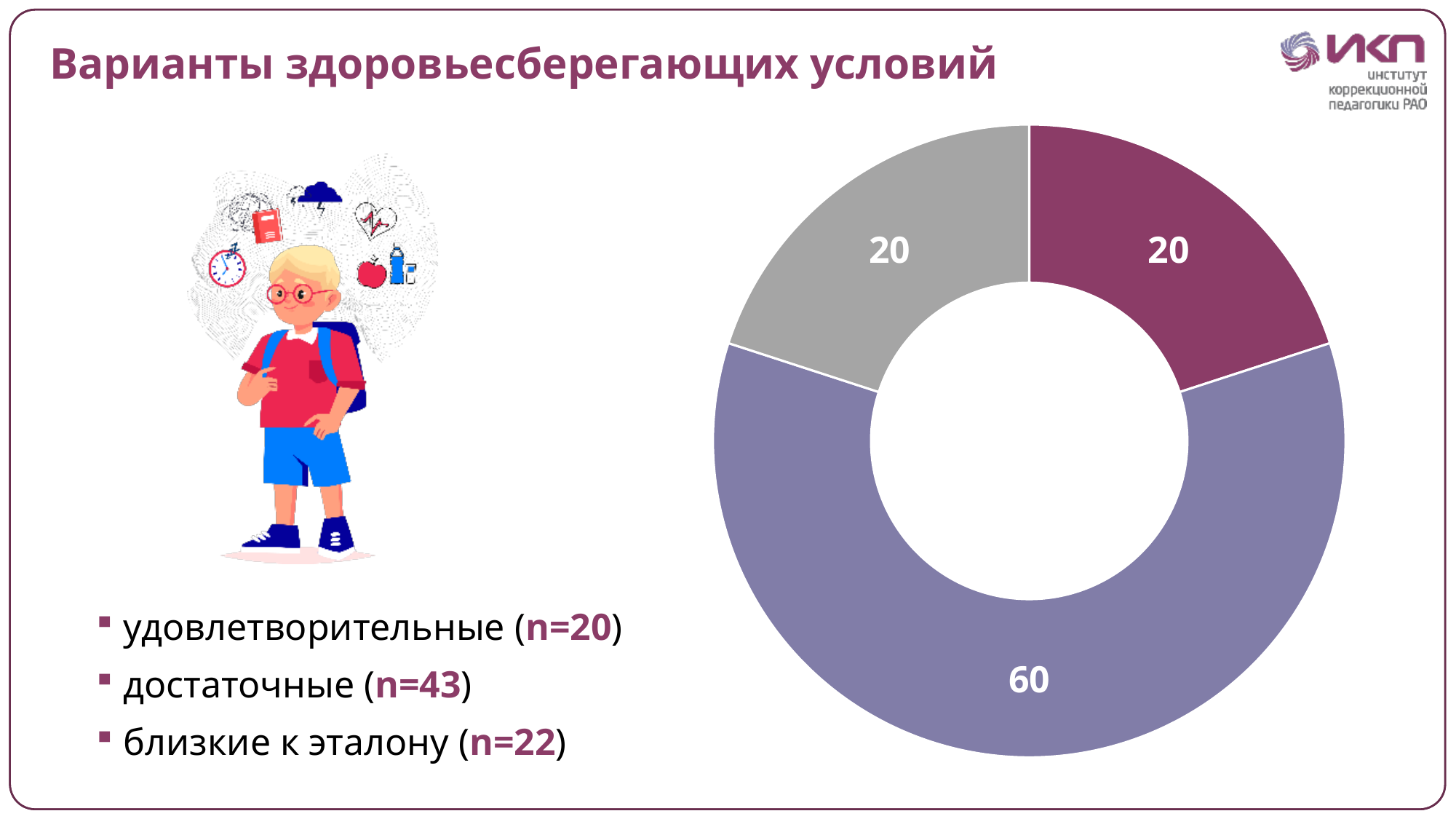
What share of the whole doughnut does the purple slice labelled 60 represent? 60% What value is printed on the dark magenta slice at the top right of the doughnut chart? 20 What value is printed on the purple slice at the bottom of the doughnut chart? 60 What kind of chart is shown on the slide? Doughnut (pie) chart Which is larger, the purple slice or the dark magenta slice? The purple slice What value is printed on the grey slice at the top left of the doughnut chart? 20 What is the total of all the values printed on the doughnut chart? 100 What is the title of the slide containing the chart? Варианты здоровьесберегающих условий What is the difference between the purple slice (60) and the grey slice (20)? 40 Does the doughnut chart display a legend? No What is the value of the largest slice of the doughnut chart? 60 How many slices does the doughnut chart have? 3